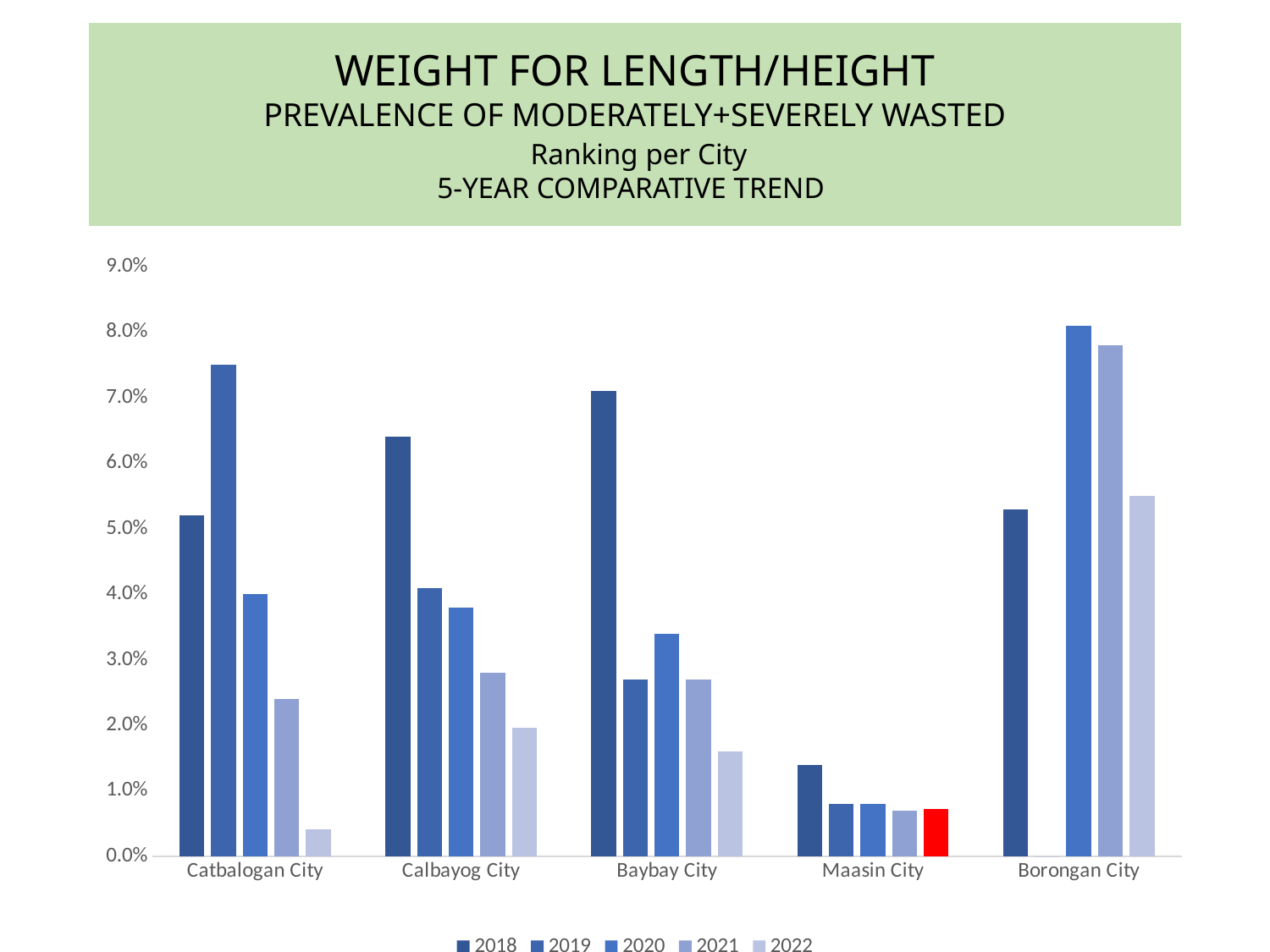
Which city has the tallest bar in the chart? Borongan City Is the 2018 value for Calbayog City greater or less than 6.0%? greater Which bar is coloured red in the chart? Maasin City 2022 Is the 2018 value for Baybay City greater or less than 6.0%? greater Which city has the lowest 2018 value? Maasin City What kind of chart is shown on the slide? bar chart Is the 2018 value for Maasin City greater or less than 2.0%? less How many cities are shown on the x axis? 5 Which has the larger 2018 value, Catbalogan City or Calbayog City? Calbayog City How many series does the legend list? 5